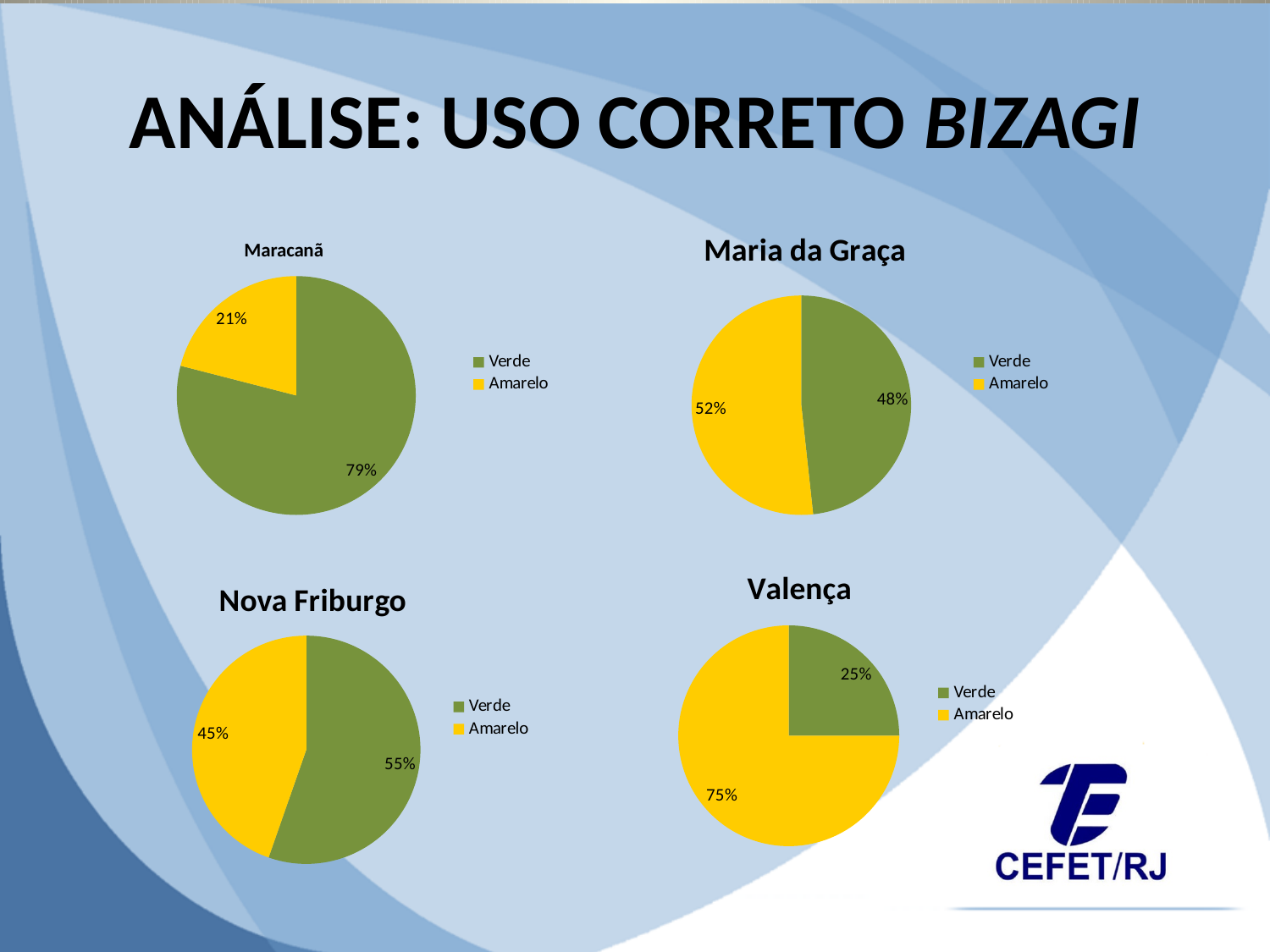
In the Maria da Graça chart, what share does Amarelo have? 52% In the Maracanã chart, what share does Amarelo have? 21% In the Valença chart, which slice is larger, Verde or Amarelo? Amarelo In the Maria da Graça chart, what share does Verde have? 48% In the Valença chart, what share does Amarelo have? 75% In the Maracanã chart, what share does Verde have? 79% In the Nova Friburgo chart, what is the difference between the Verde and Amarelo shares? 10% In the Maracanã chart, what is the difference between the Verde and Amarelo shares? 58% In the Nova Friburgo chart, what share does Verde have? 55% How many slices does the Maria da Graça chart have? 2 How many entries does the legend of the Nova Friburgo chart list? 2 What kind of chart is the Valença chart? Pie chart